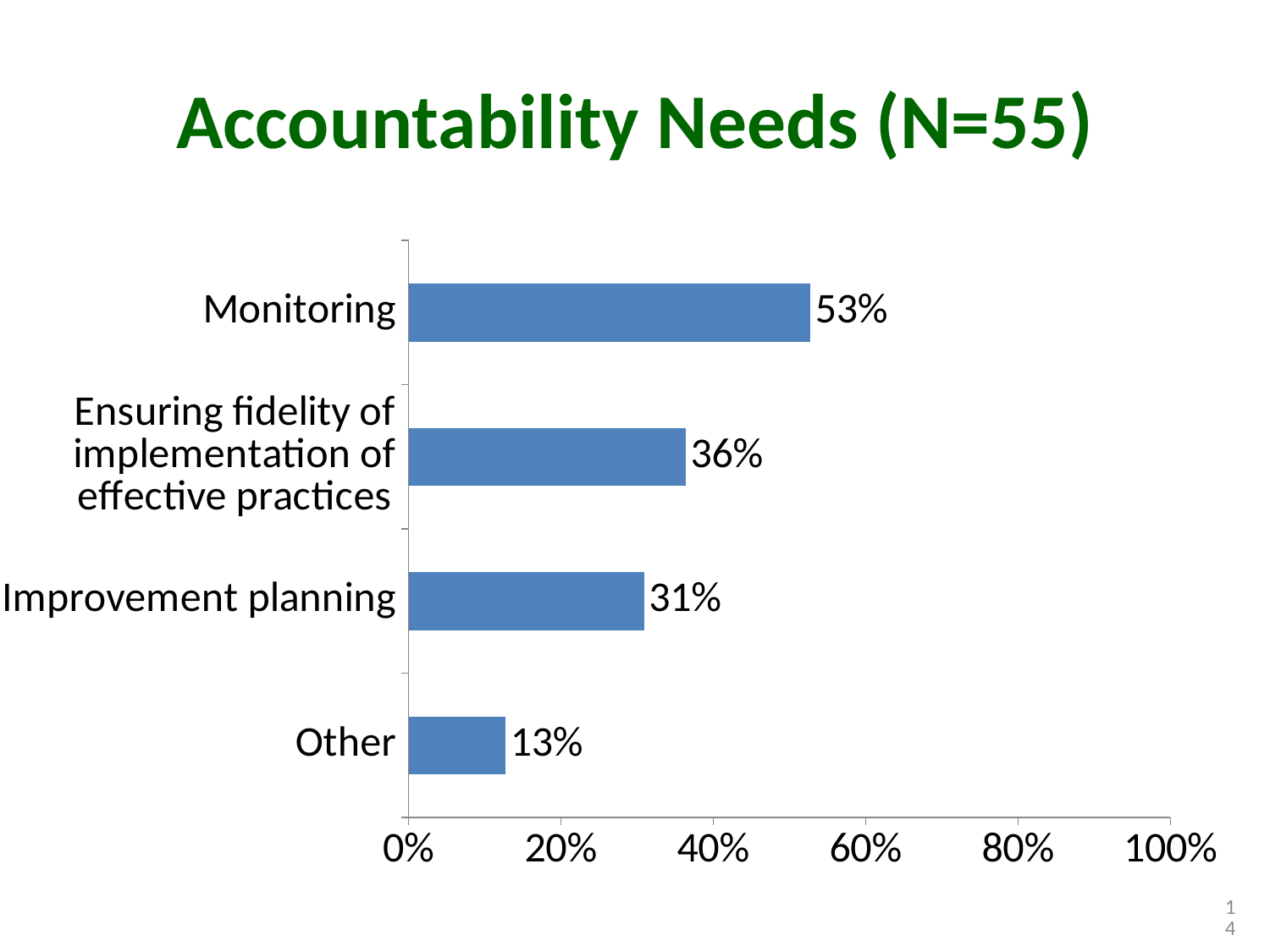
What is the difference between the values for Monitoring and Other? 40% Is the value for Monitoring greater or less than 40%? greater What is the difference between the values for Ensuring fidelity of implementation of effective practices and Improvement planning? 5% What is the value for Ensuring fidelity of implementation of effective practices? 36% What kind of chart is shown on the slide? Bar chart Which is larger, the value for Improvement planning or the value for Other? Improvement planning Which category has the lowest value? Other What is the value for Monitoring? 53% What is the value for Improvement planning? 31% What is the value for Other? 13% Which category has the highest value? Monitoring How many categories are shown in the chart? 4